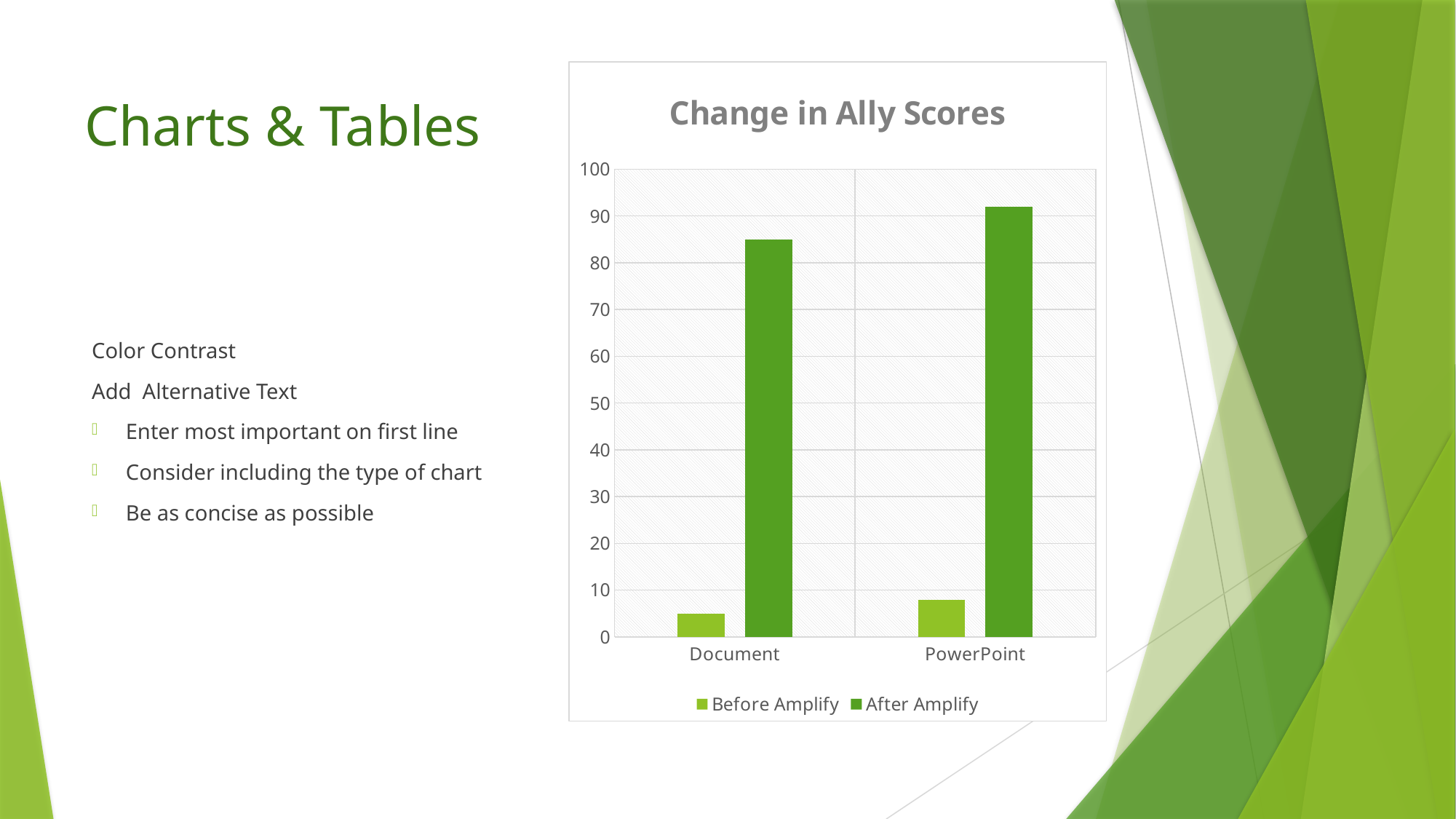
How many categories are shown on the x axis of the chart? 2 Is the After Amplify value for PowerPoint greater or less than 80? greater Which category has the lowest Before Amplify value? Document Which series is shown in the darker green colour in the chart? After Amplify Is the After Amplify value for Document greater or less than 80? greater What kind of chart is shown on the slide? bar chart How many series does the chart legend list? 2 What is the title of the chart? Change in Ally Scores Is the After Amplify value for Document greater or less than 90? less Which category has the higher After Amplify value, Document or PowerPoint? PowerPoint